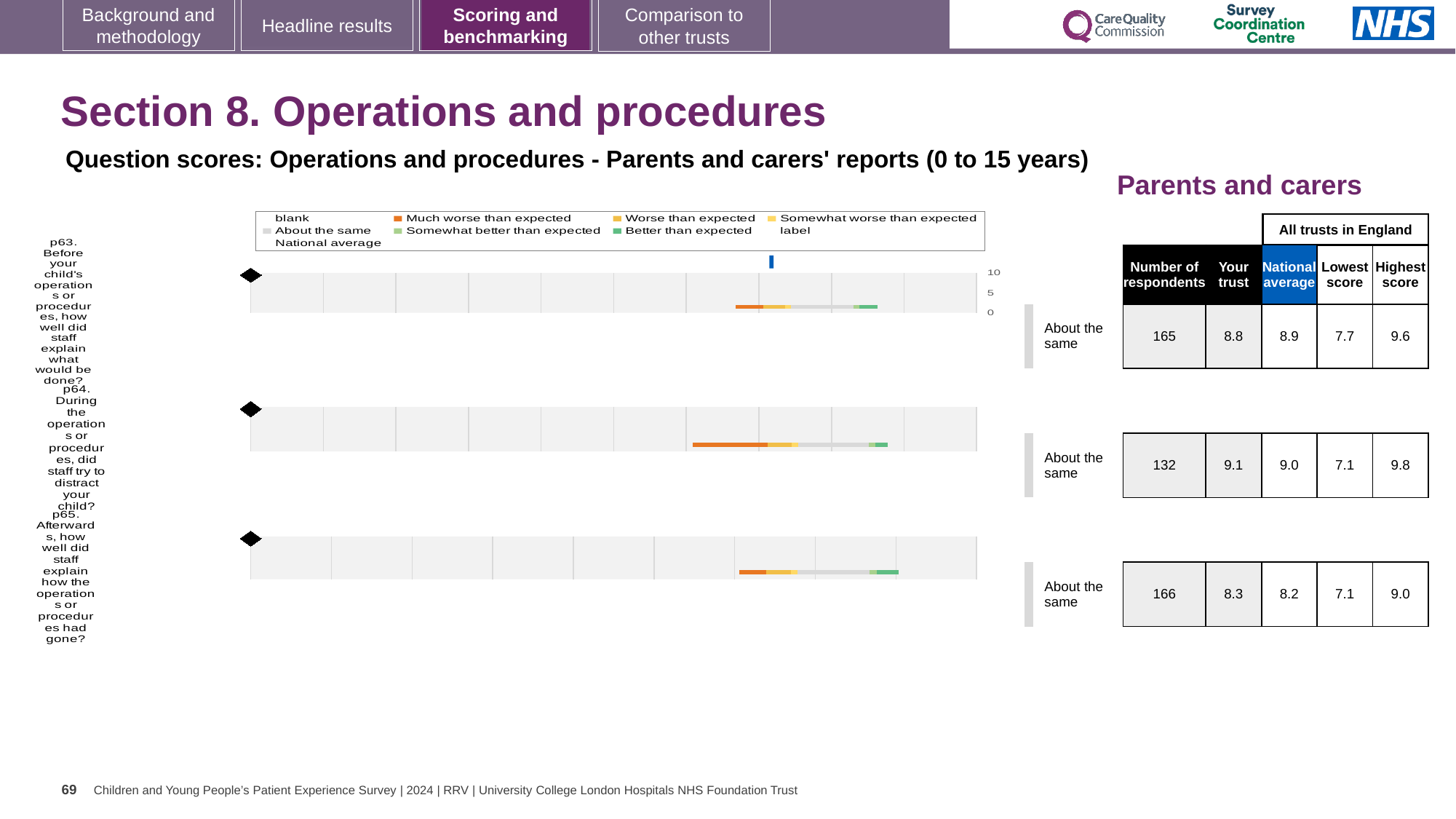
What is the national average score for p64 (During the operations or procedures, did staff try to distract your child?)? 9.0 Which of the three questions has the highest 'Your trust' score? p64 How many entries does the chart legend list? 9 For p65, is the 'Your trust' score or the national average score larger? Your trust How many questions (charts) are shown on the slide for Operations and procedures? 3 What kind of chart is used to show the question scores for p63, p64 and p65? Bar chart What is the 'Your trust' score for p63 (Before your child's operations or procedures, how well did staff explain what would be done?)? 8.8 What is the highest score across all trusts in England for p64? 9.8 Which of the three questions has the fewest respondents? p64 How many respondents answered p65 (Afterwards, how well did staff explain how the operations or procedures had gone?)? 166 For p63, what is the difference between the highest score and the lowest score across all trusts in England? 1.9 What benchmark category is shown next to each of the three charts? About the same